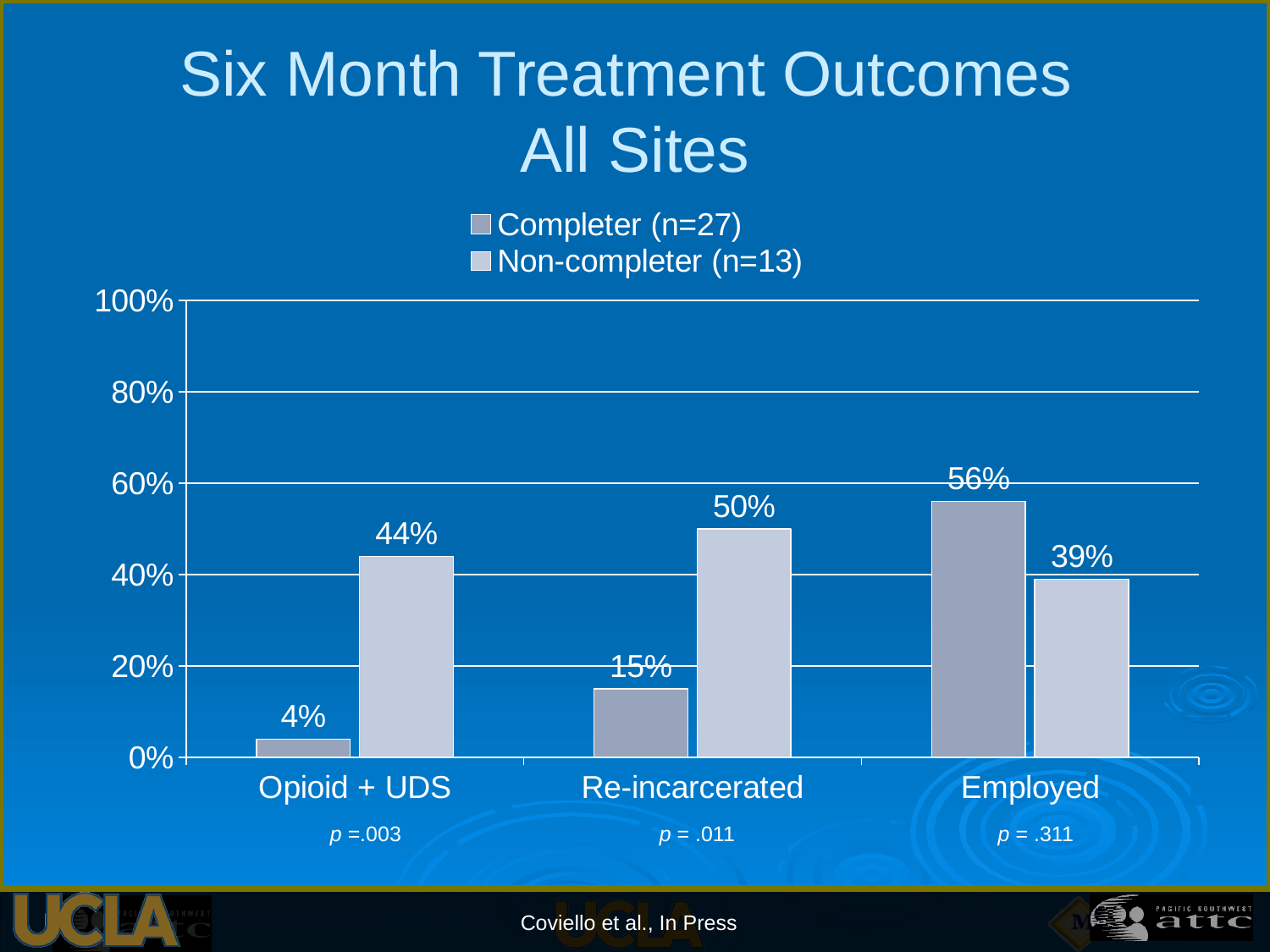
Which category has the lowest Completer (n=27) value? Opioid + UDS What is the Non-completer (n=13) value for Re-incarcerated? 50% Which category has the highest Completer (n=27) value? Employed What is the difference between the Non-completer (n=13) and Completer (n=27) values for Re-incarcerated? 35% For Employed, which group has the larger value, Completer (n=27) or Non-completer (n=13)? Completer (n=27) How many series does the legend list? 2 What is the Completer (n=27) value for Opioid + UDS? 4% Is the Non-completer (n=13) value for Employed greater or less than 20%? greater How many categories are shown on the x axis? 3 What is the Completer (n=27) value for Employed? 56% What kind of chart is shown on the slide? Bar chart What is the Non-completer (n=13) value for Opioid + UDS? 44%